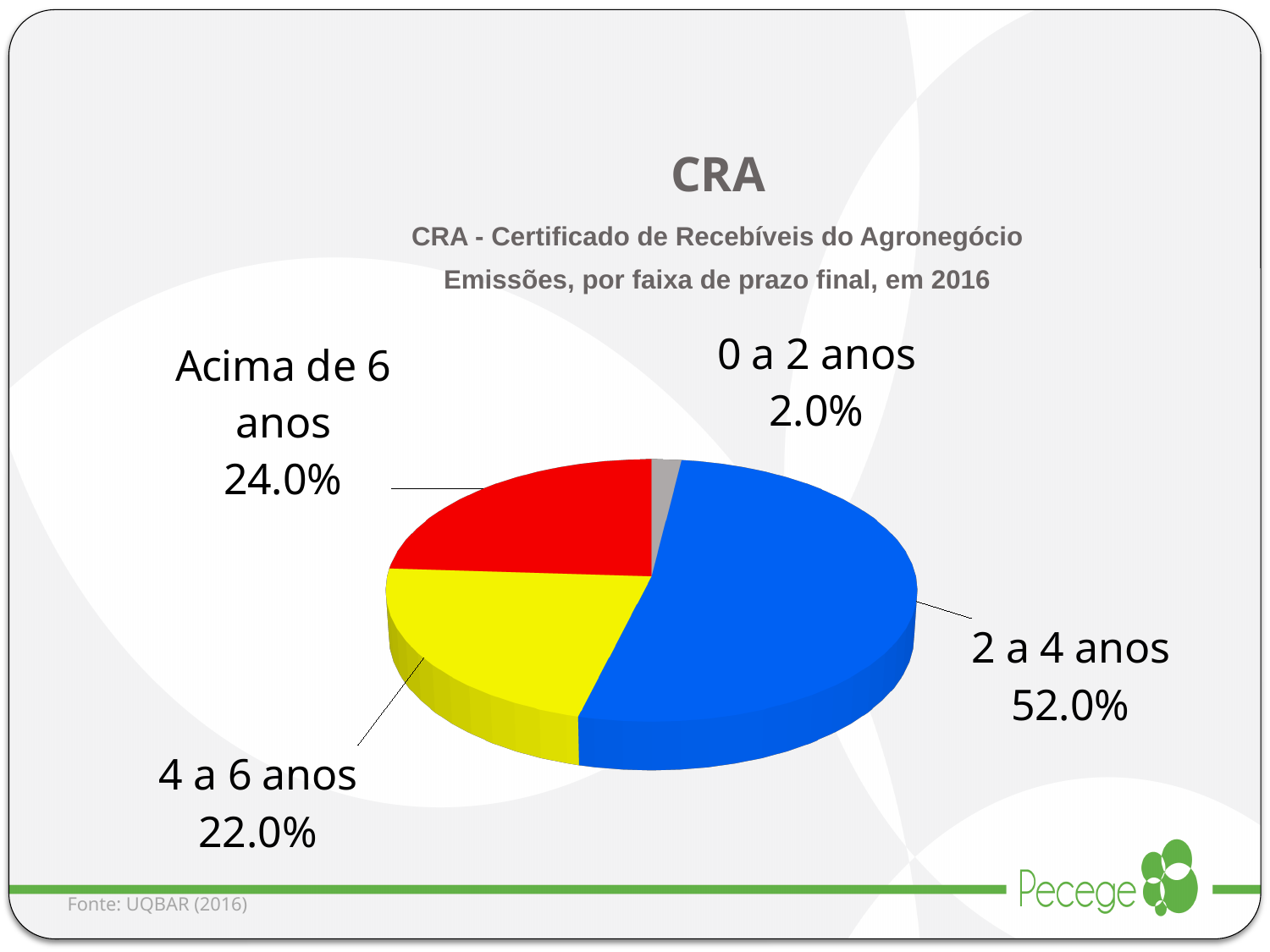
What is the difference in percentage points between the 2 a 4 anos share and the Acima de 6 anos share? 28.0 percentage points What is the source cited for the chart data? UQBAR (2016) What share of CRA emissions in 2016 had a final term of Acima de 6 anos? 24.0% What colour is the slice for 2 a 4 anos? Blue What share of CRA emissions in 2016 had a final term of 4 a 6 anos? 22.0% What kind of chart is used on this slide? Pie chart Which has a larger share: 4 a 6 anos or Acima de 6 anos? Acima de 6 anos What share of CRA emissions in 2016 had a final term of 0 a 2 anos? 2.0% Which term range has the smallest share of CRA emissions in 2016? 0 a 2 anos What share of CRA emissions in 2016 had a final term of 2 a 4 anos? 52.0% Which term range has the largest share of CRA emissions in 2016? 2 a 4 anos How many term ranges (slices) does the pie chart show? 4